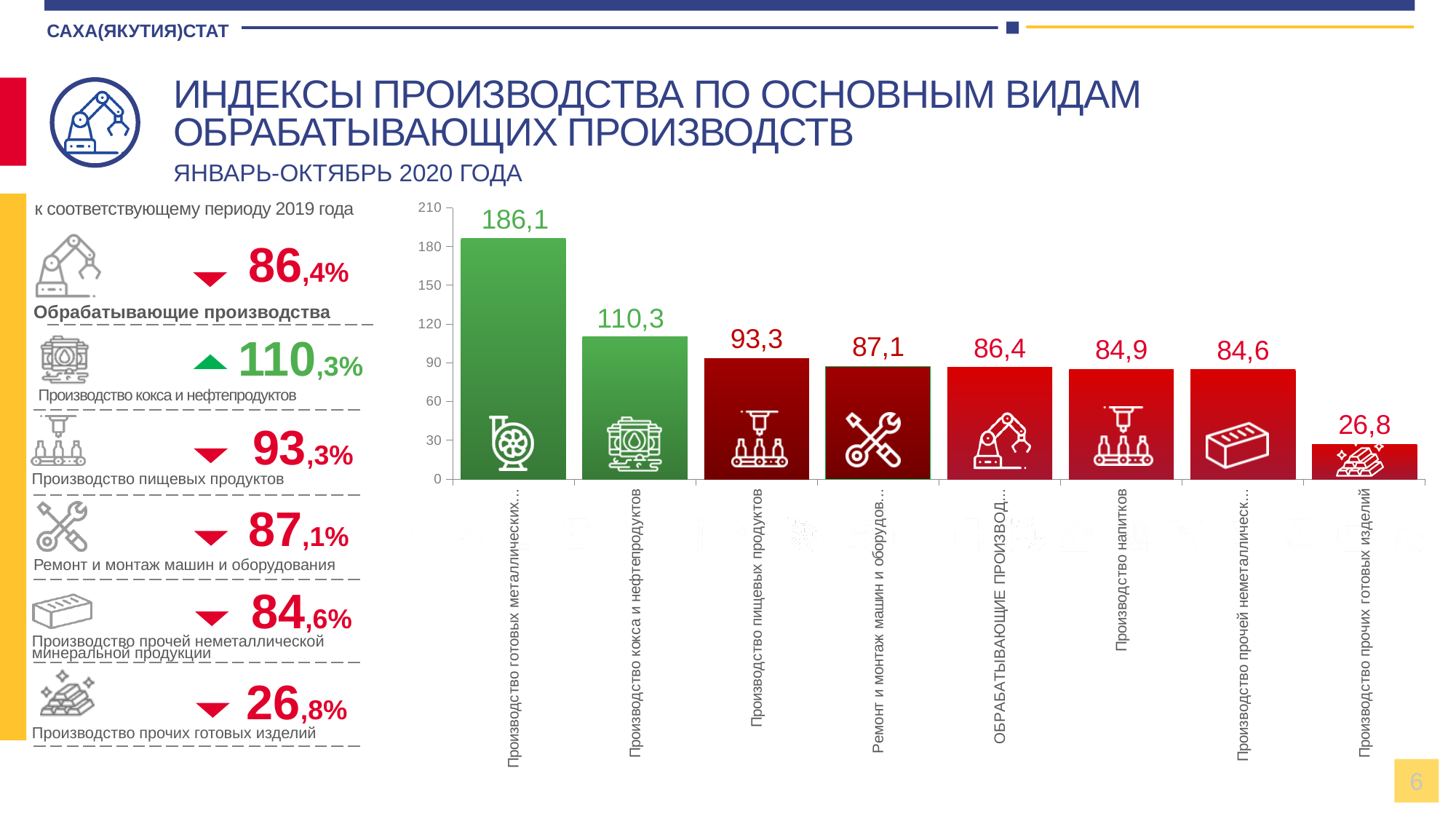
How many bars are shown in the chart? 8 What is the difference between the values for Производство кокса и нефтепродуктов and Производство пищевых продуктов? 17,0 What is the value for Производство прочих готовых изделий in the bar chart? 26,8 What is the value for Производство кокса и нефтепродуктов in the bar chart? 110,3 What is the difference between the highest bar (186,1) and the lowest bar (26,8)? 159,3 What kind of chart is shown on the slide? bar chart What is the value of the first (leftmost) bar in the chart? 186,1 Which category has the lowest value in the bar chart? Производство прочих готовых изделий Do the values rise or fall from left to right along the x axis? fall What is the value for Производство напитков in the bar chart? 84,9 Which category has the highest value in the bar chart? Производство готовых металлических… (the first bar) Which is larger: the value for Производство пищевых продуктов or for Производство напитков? Производство пищевых продуктов